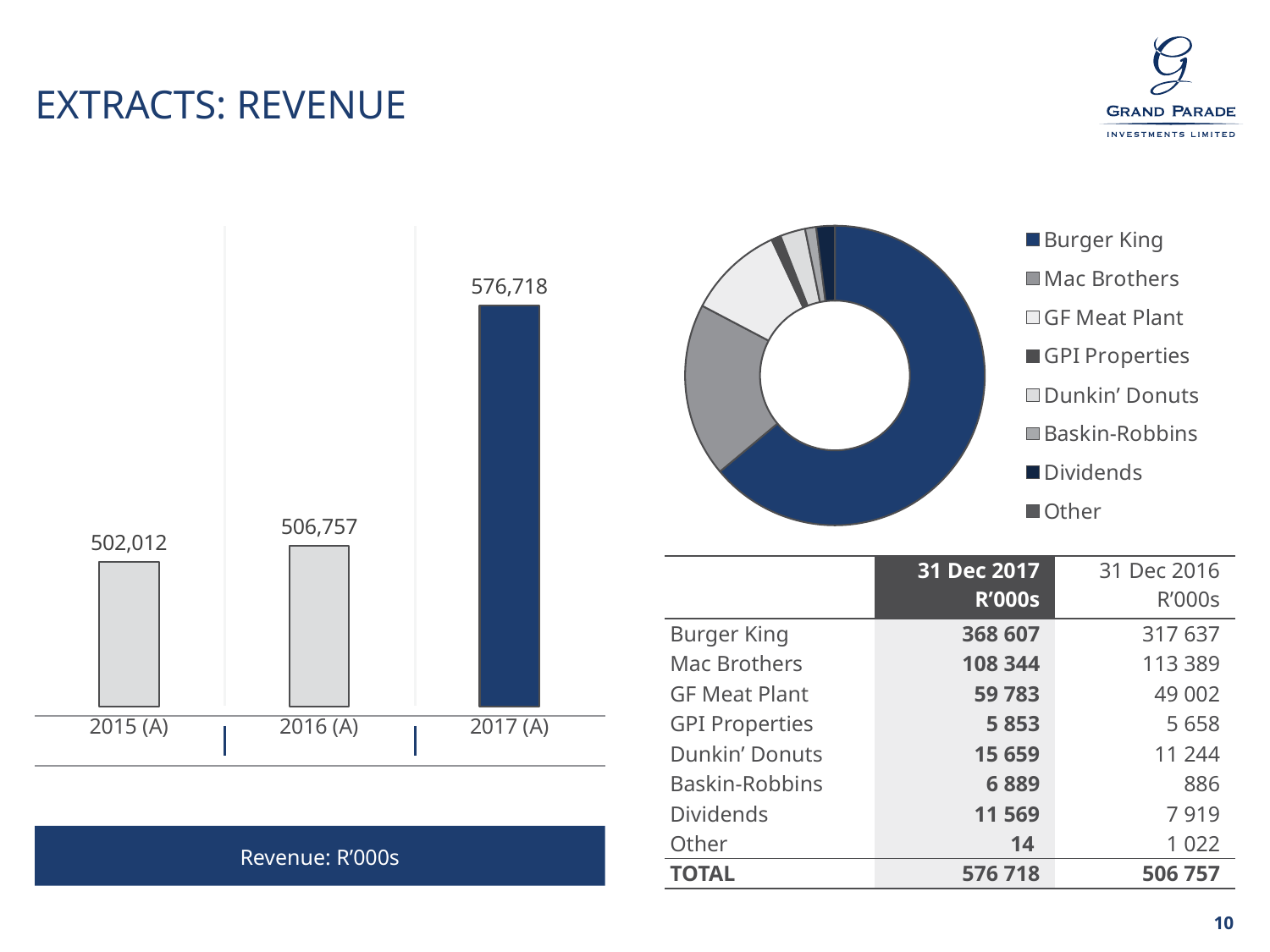
What kind of chart is shown on the left of the slide? bar chart On the bar chart on the left, what is the revenue value for 2016 (A)? 506,757 On the bar chart on the left, what is the difference between the 2017 (A) and 2016 (A) values? 69,961 How many entries does the legend of the donut chart on the right list? 8 On the donut chart on the right, which category has the largest slice? Burger King On the bar chart on the left, what is the revenue value for 2015 (A)? 502,012 On the bar chart on the left, which year has the lowest revenue? 2015 (A) On the bar chart on the left, how many bars are shown? 3 On the bar chart on the left, what is the revenue value for 2017 (A)? 576,718 On the bar chart on the left, what is the difference between the 2016 (A) and 2015 (A) values? 4,745 On the bar chart on the left, do the values rise or fall from 2015 (A) to 2017 (A)? rise On the bar chart on the left, which year has the highest revenue? 2017 (A)